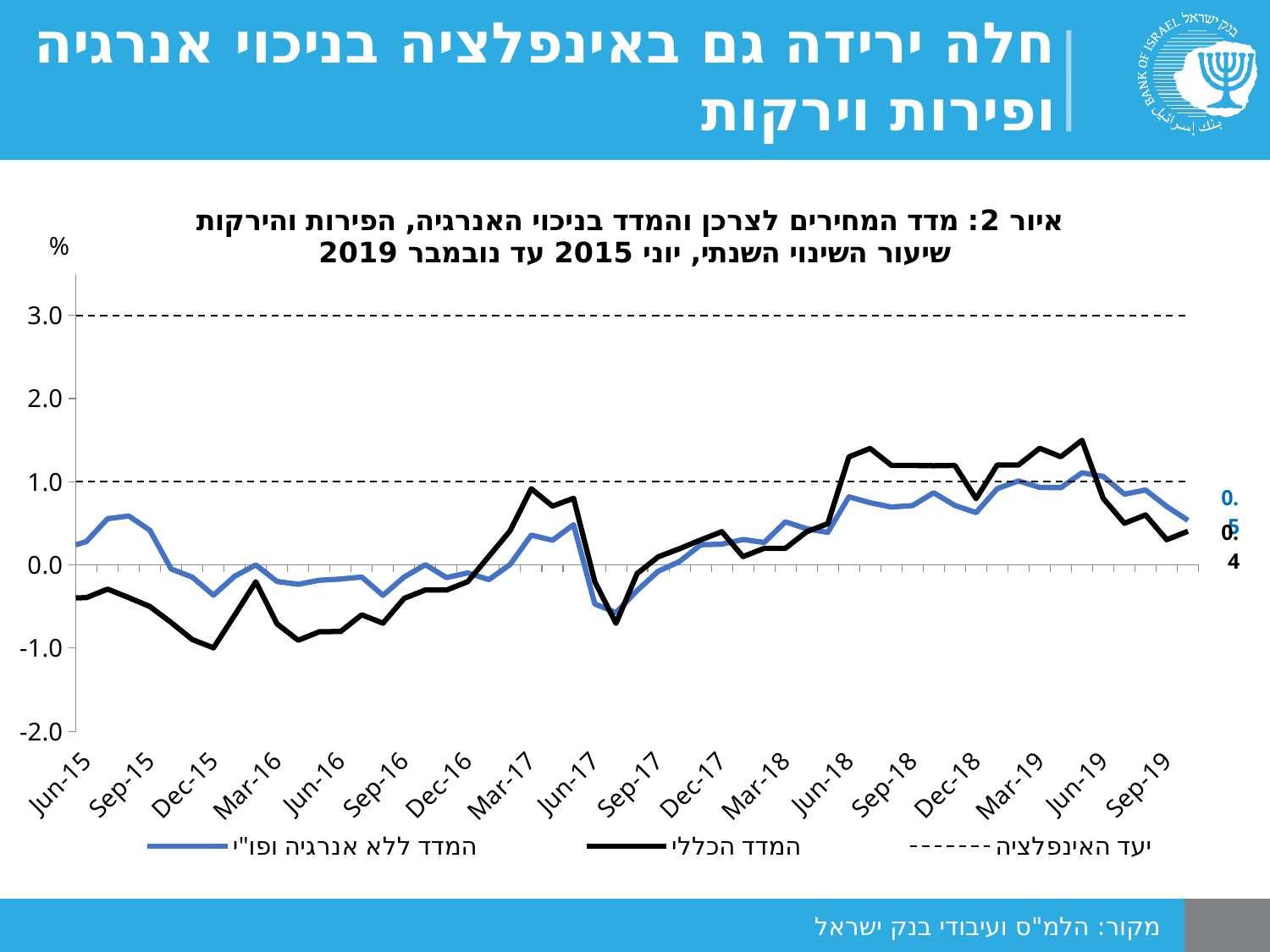
How many entries does the chart legend list? 3 What period does the chart title say the data covers? June 2015 to November 2019 (יוני 2015 עד נובמבר 2019) Is the value of the index excluding energy and fruits/vegetables (blue line) at Dec-15 greater or less than 0.0? less Does the general index (black line) rise or fall between Jun-19 and the end of the series? fall What is the last labelled value of the general index (המדד הכללי) series at the right end of the chart? 0.4 At Dec-15, which series is lower: the general index or the index excluding energy and fruits/vegetables? the general index At the right end of the chart, which series has the higher labelled value: the general index or the index excluding energy and fruits/vegetables? the index excluding energy and fruits/vegetables (0.5) Is the value of the general index (black line) at Dec-15 greater or less than 0.0? less What type of chart is shown on the slide? line chart Is the value of the general index (black line) at Sep-18 greater or less than 1.0? greater What is the last labelled value of the index excluding energy and fruits/vegetables (המדד ללא אנרגיה ופו"י) at the right end of the chart? 0.5 At what values are the two dashed inflation-target lines drawn? 1.0 and 3.0